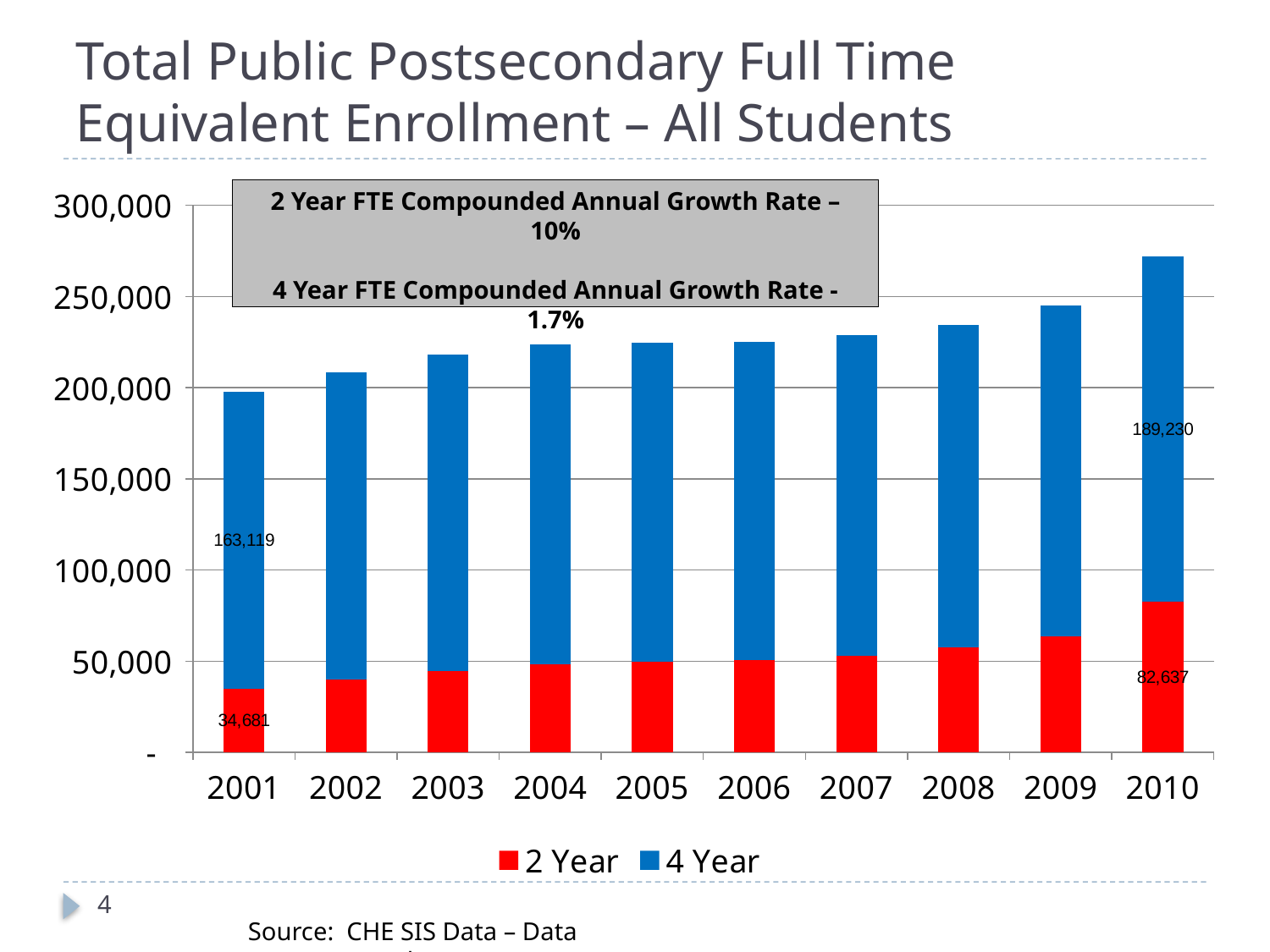
By how much did the 2 Year FTE enrollment increase from 2001 to 2010? 47,956 Is the total FTE enrollment for 2005 greater or less than 200,000? greater Which year has the highest total FTE enrollment? 2010 What is the 4 Year value labeled on the 2001 bar? 163,119 What is the 2 Year value labeled on the 2010 bar? 82,637 What is the total FTE enrollment (2 Year plus 4 Year) for 2001? 197,800 How many years are shown on the x axis? 10 What is the 4 Year FTE enrollment value shown for 2010? 189,230 What is the 2 Year FTE enrollment value shown for 2001? 34,681 Is the 2 Year FTE enrollment for 2002 greater or less than 50,000? less What is the 2 Year FTE compounded annual growth rate stated on the slide? 10% What is the total FTE enrollment (2 Year plus 4 Year) for 2010? 271,867